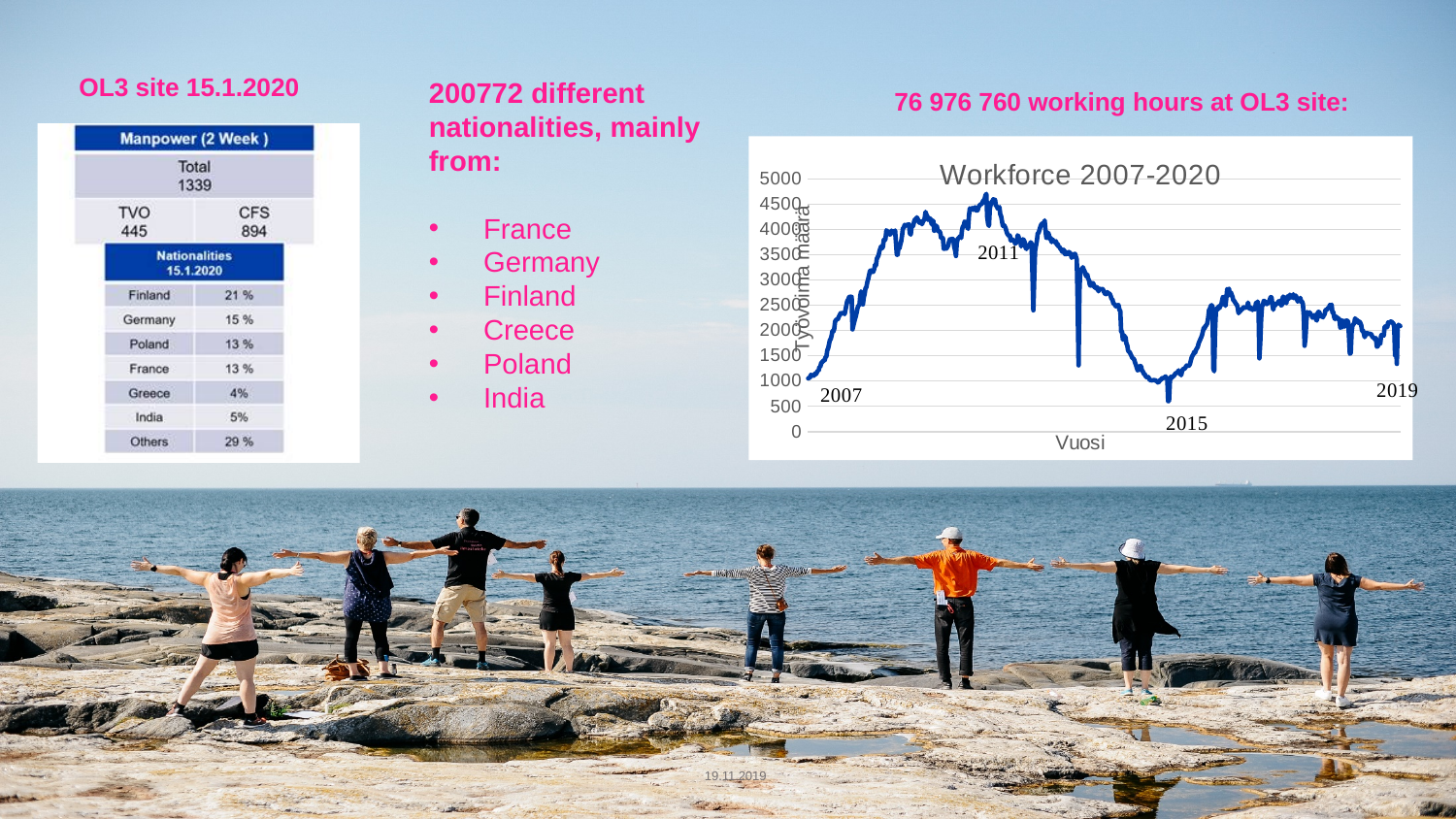
How many year labels are shown on the x-axis of the Workforce 2007-2020 chart? 4 In the Workforce 2007-2020 chart, does the workforce rise or fall between 2011 and 2015? fall What kind of chart is the Workforce 2007-2020 chart? line chart What is the highest value shown on the y-axis of the Workforce 2007-2020 chart? 5000 In the Workforce 2007-2020 chart, does the workforce rise or fall between 2007 and 2011? rise In the Workforce 2007-2020 chart, is the peak value around 2011 greater or less than 4000? greater In the Workforce 2007-2020 chart, is the value at the start in 2007 greater or less than 1500? less What is the title of the chart on the right of the slide? Workforce 2007-2020 In the Workforce 2007-2020 chart, is the lowest value around 2015 greater or less than 1000? less In the Workforce 2007-2020 chart, is the workforce higher around 2011 or around 2015? 2011 What is the x-axis title of the Workforce 2007-2020 chart? Vuosi